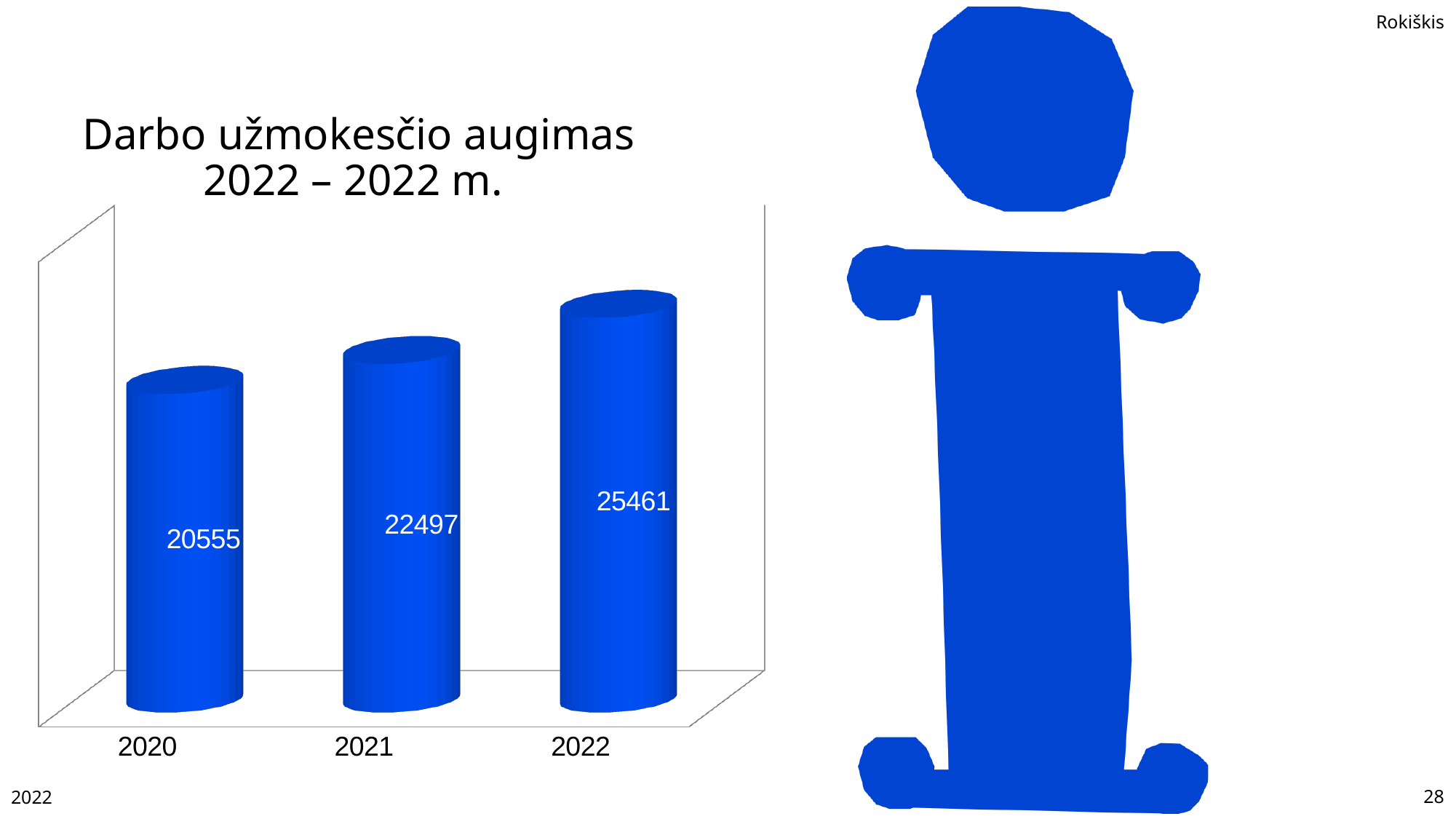
How many years are shown on the chart? 3 Which is larger, the value for 2021 or the value for 2022? 2022 Do the values rise or fall from 2020 to 2022? rise What is the difference between the values for 2021 and 2020? 1942 What is the difference between the values for 2022 and 2020? 4906 What is the value for 2022? 25461 Which year has the highest value? 2022 What is the title of the chart? Darbo užmokesčio augimas 2022 – 2022 m. What is the value for 2021? 22497 What is the value for 2020? 20555 What kind of chart is shown on the slide? bar chart Which year has the lowest value? 2020